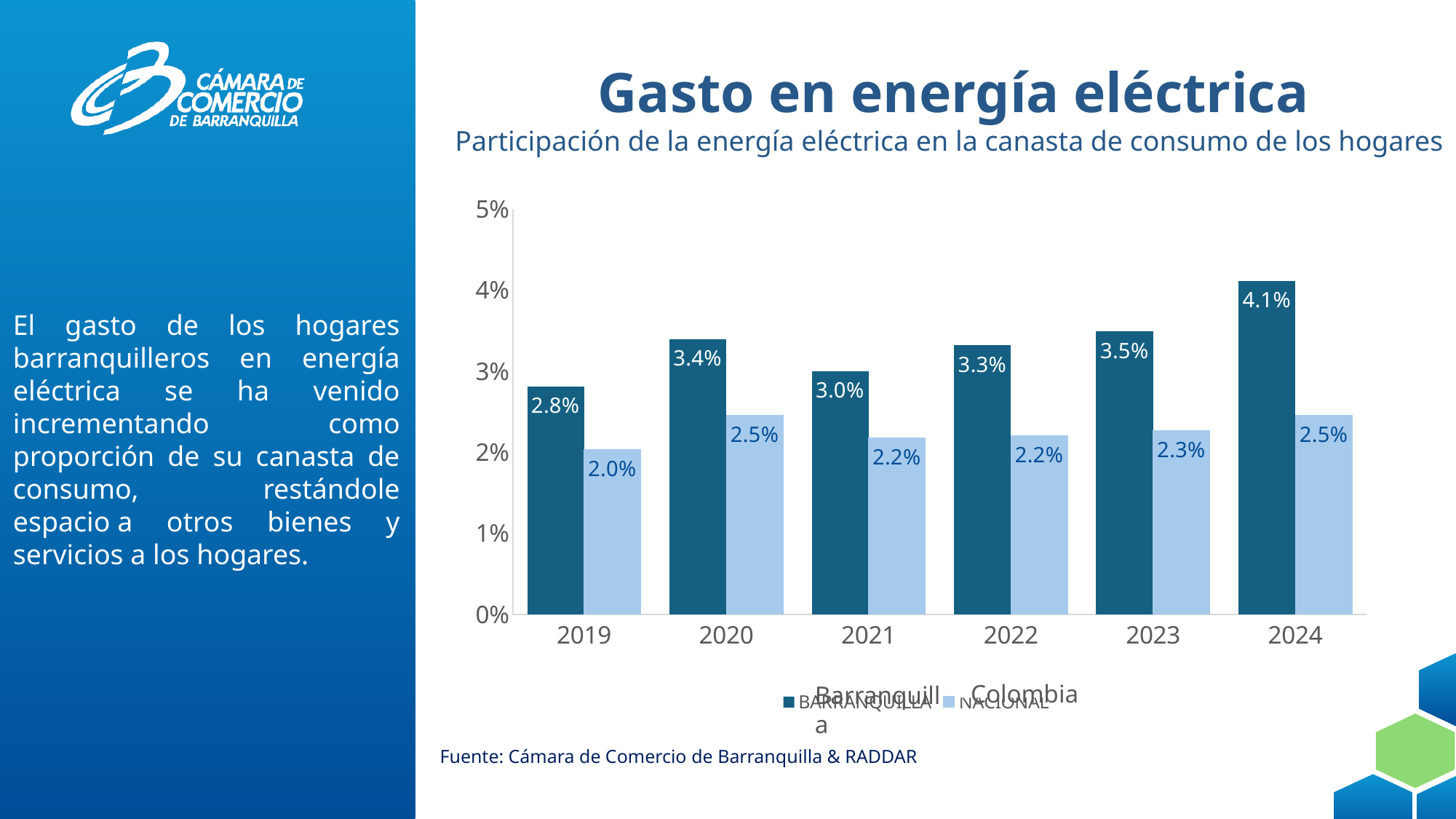
What is the value for Barranquilla in 2021? 3.0% What is the difference between the Barranquilla values in 2020 and 2019? 0.6% What is the title of the chart? Gasto en energía eléctrica What is the difference between the Barranquilla and Colombia values in 2024? 1.6% In which year is the Barranquilla value highest? 2024 What kind of chart is shown on the slide? Bar chart In which year is the Barranquilla value lowest? 2019 What is the value for Colombia in 2019? 2.0% What is the value for Colombia in 2023? 2.3% How many years are shown on the x axis? 6 What is the value for Barranquilla in 2024? 4.1% Which is larger in 2022, the Barranquilla value or the Colombia value? Barranquilla